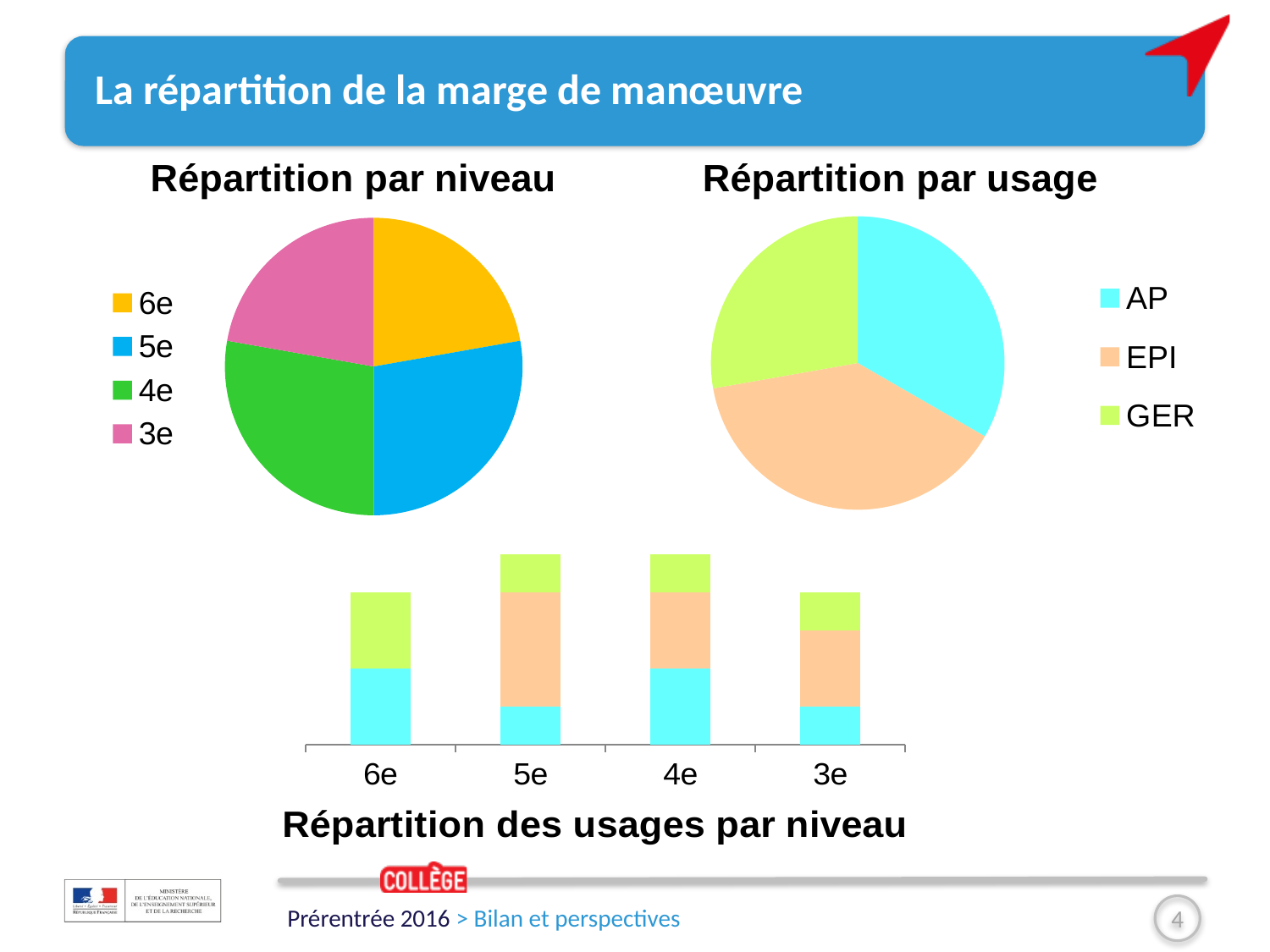
In "Répartition par usage", which category has the smallest slice? GER In "Répartition par usage", which category has the largest slice? EPI In "Répartition par niveau", which slice is larger, 4e or 3e? 4e In "Répartition par niveau", what are the legend entries? 6e, 5e, 4e, 3e In "Répartition des usages par niveau", how many categories are shown on the x axis? 4 In "Répartition par usage", which slice is larger, EPI or AP? EPI In "Répartition des usages par niveau", how many segments does the 6e bar contain? 2 What kind of chart is "Répartition par niveau"? pie chart What kind of chart is "Répartition des usages par niveau"? bar chart In "Répartition par niveau", what colour represents 5e? blue In "Répartition par niveau", how many slices does the pie have? 4 In "Répartition par usage", how many entries does the legend list? 3